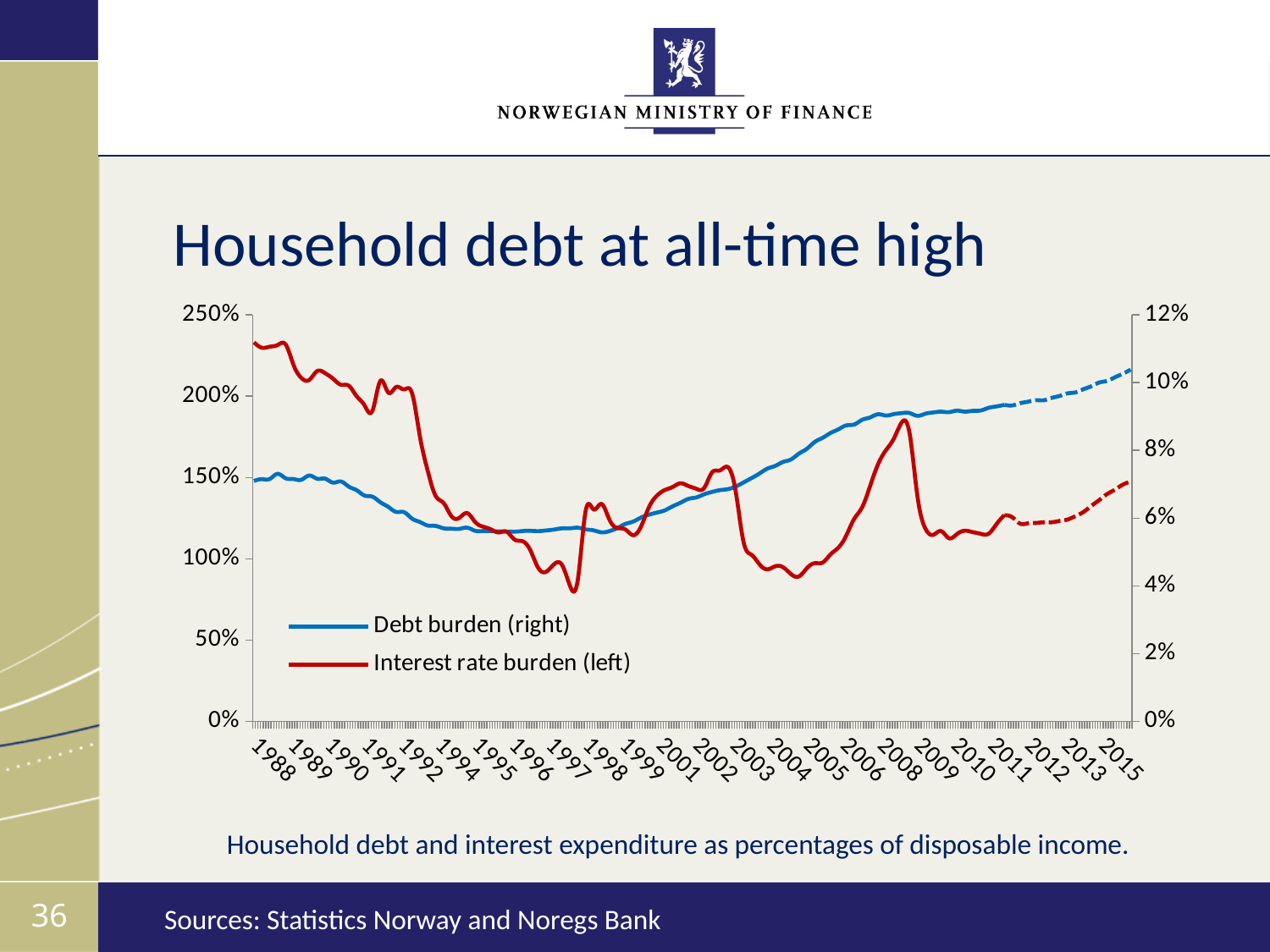
Does the Interest rate burden line rise or fall between 1988 and 1997? fall What is the highest value shown on the right-hand axis? 12% What colour is the Debt burden line? blue What kind of chart is shown on the slide? line chart What is the title of the chart on the slide? Household debt at all-time high Is the Interest rate burden higher in 1988 or in 2008? 1988 What is the first year shown on the x axis? 1988 Does the Debt burden line rise or fall between 2004 and 2015? rise What is the highest value shown on the left-hand axis? 250% What is the last year shown on the x axis? 2015 How many series does the legend list? 2